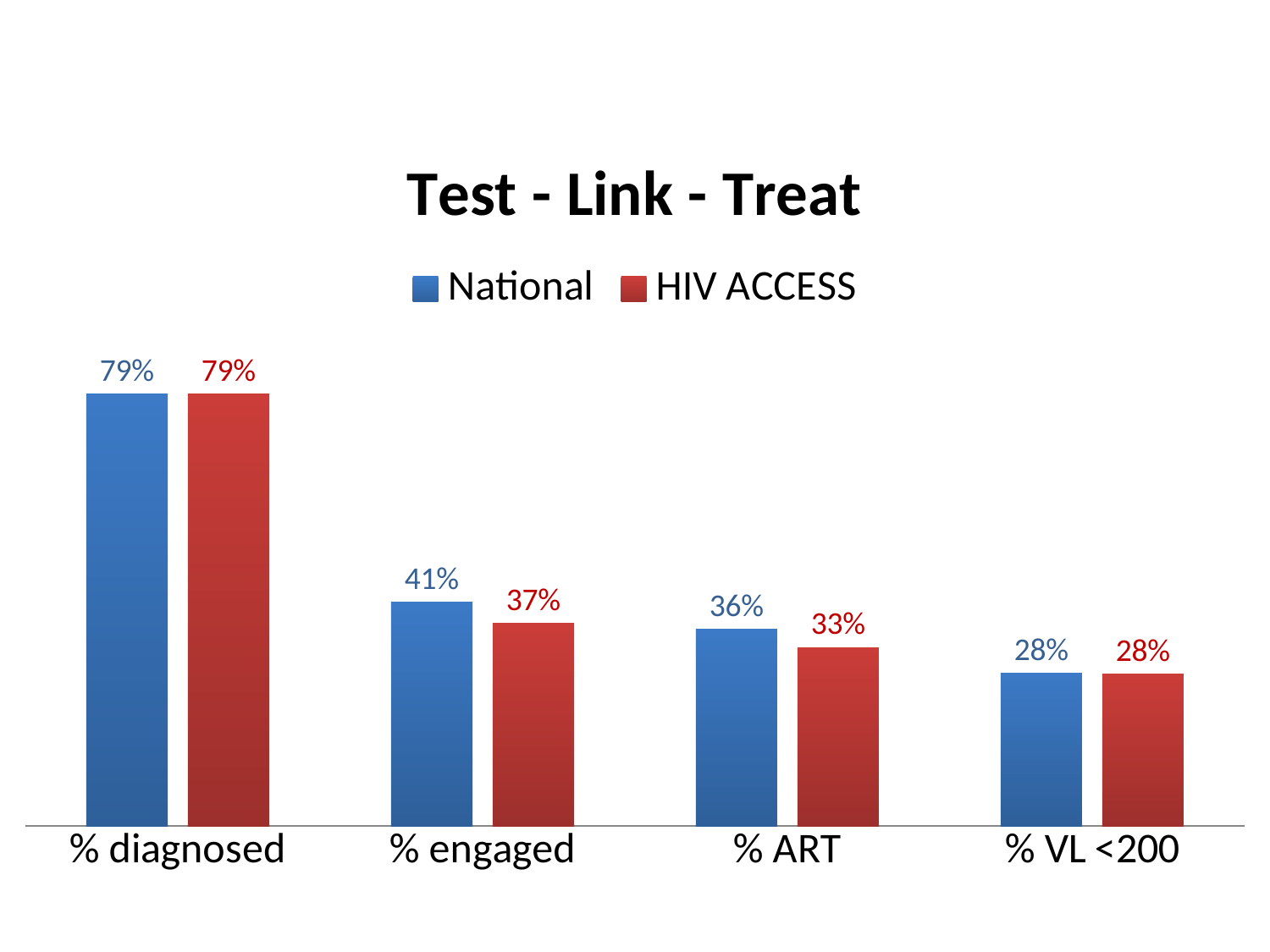
What is the National value for % VL <200? 28% Which category has the highest National value? % diagnosed What type of chart is shown? Bar chart Which category has the lowest HIV ACCESS value? % VL <200 How many series does the legend list? 2 What is the National value for % engaged? 41% What is the HIV ACCESS value for % diagnosed? 79% How many categories are shown on the x axis? 4 What is the difference between the National and HIV ACCESS values for % engaged? 4% What is the HIV ACCESS value for % ART? 33% Which is larger for % ART, the National value or the HIV ACCESS value? National What is the difference between the National values for % diagnosed and % ART? 43%